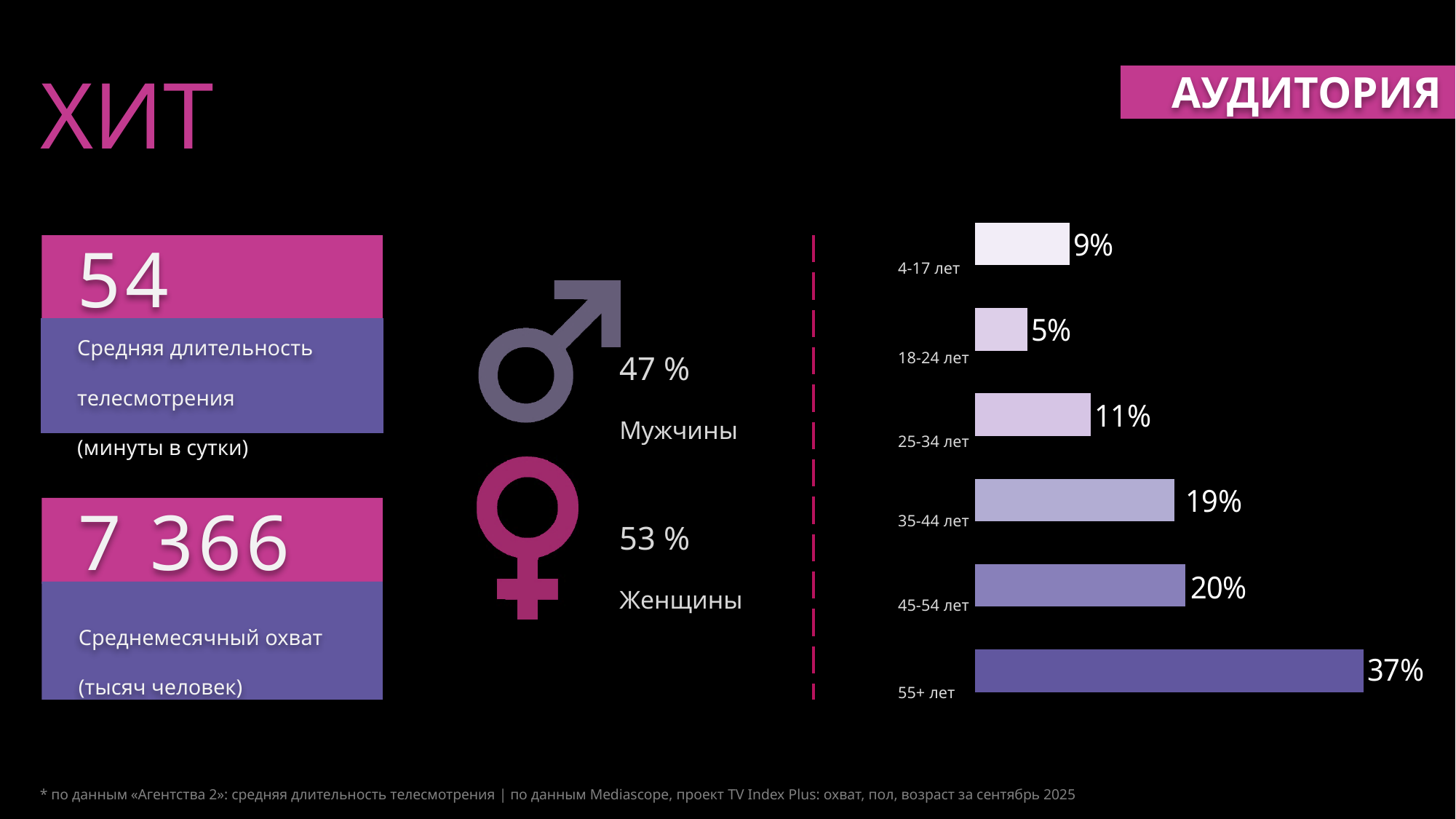
Which is larger in the bar chart: the value for 35-44 лет or the value for 25-34 лет? 35-44 лет Which age group has the highest value in the bar chart? 55+ лет Which age group has the lowest value in the bar chart? 18-24 лет How many age groups are shown in the bar chart? 6 Do the values in the bar chart rise or fall from 25-34 лет to 55+ лет? Rise What kind of chart shows the age groups on the slide? Bar chart What is the difference between the values for 55+ лет and 45-54 лет in the bar chart? 17% What is the value for the 55+ лет age group in the bar chart? 37% What is the value for the 4-17 лет age group in the bar chart? 9% What is the value for the 35-44 лет age group in the bar chart? 19% What is the difference between the values for 25-34 лет and 4-17 лет in the bar chart? 2% What is the value for the 18-24 лет age group in the bar chart? 5%